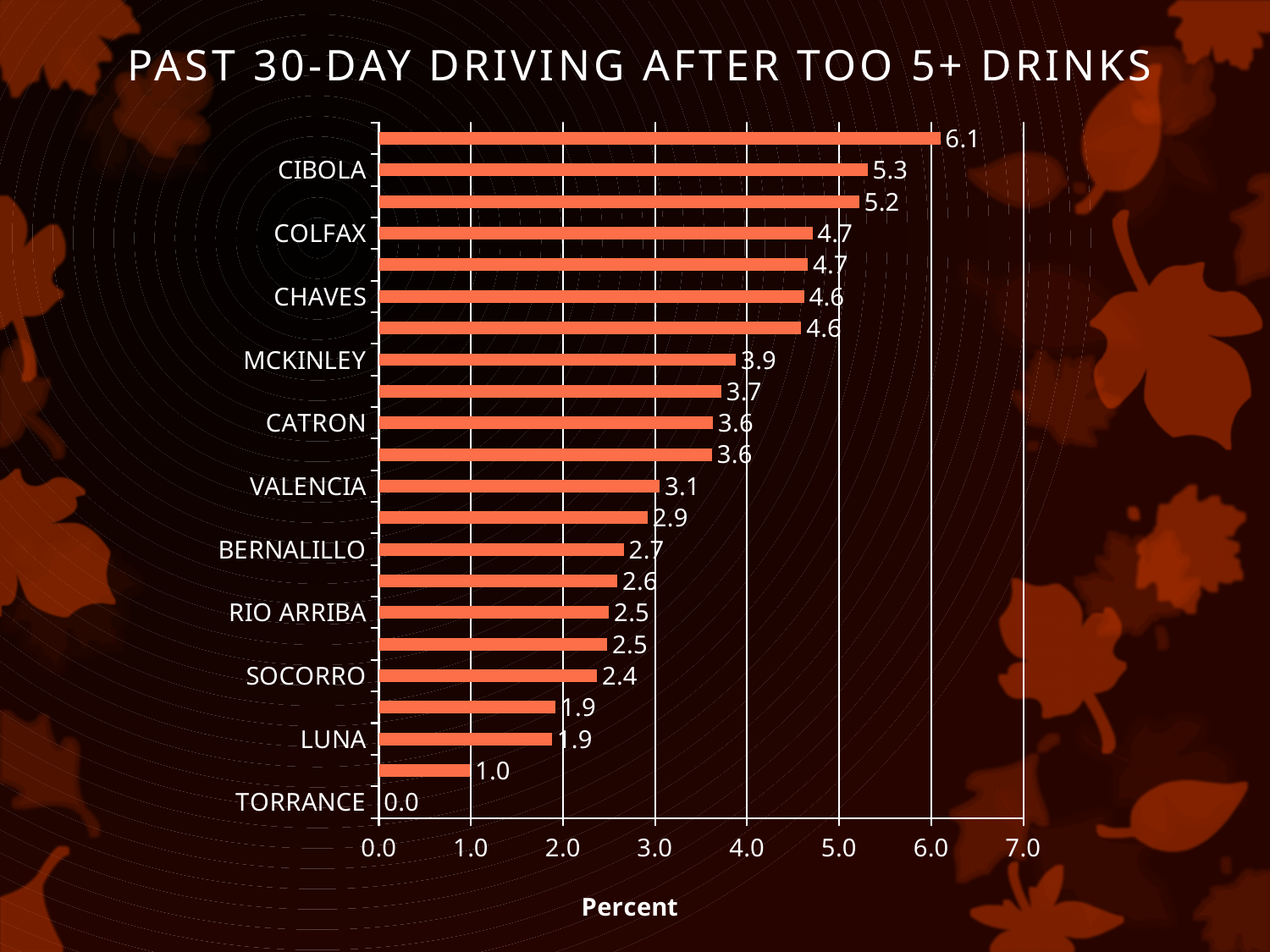
What is the highest value shown on the chart? 6.1 How many bars are plotted on the chart? 22 Which labeled county has the lowest value? TORRANCE What is the difference between the values for COLFAX and CATRON? 1.1 What is the value for LUNA? 1.9 What is the value for MCKINLEY? 3.9 What is the label on the horizontal axis? Percent What kind of chart is shown on the slide? bar chart Is the value for SOCORRO greater or less than 3.0? less Which is larger, the value for CHAVES or the value for VALENCIA? CHAVES What is the value for BERNALILLO? 2.7 What is the value for CIBOLA? 5.3